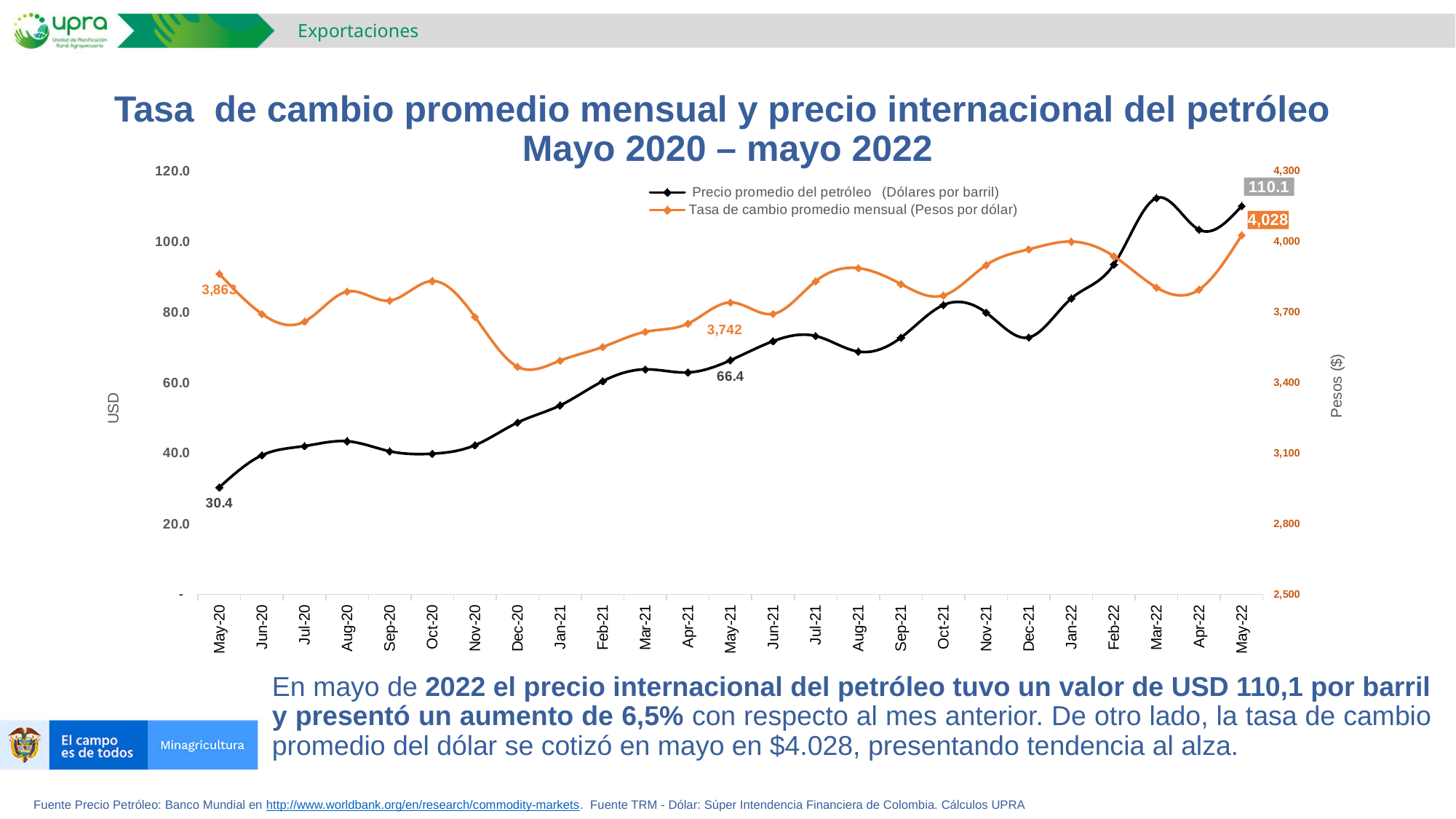
In which month was the average oil price lowest? May-20 What was the average oil price in May-21? 66.4 What was the average oil price in May-22? 110.1 What was the monthly average exchange rate (Tasa de cambio promedio mensual) in May-20? 3,863 Is the average oil price for Dec-20 greater or less than 60.0? less What was the average oil price (Precio promedio del petróleo) in May-20? 30.4 What kind of chart is shown on the slide? Line chart What is the difference between the exchange rate in May-22 and in May-21? 286 How many series does the legend list? 2 By how much did the average oil price in May-22 exceed the value in May-20? 79.7 Which month had the higher exchange rate, May-20 or May-21? May-20 What was the monthly average exchange rate in May-22? 4,028